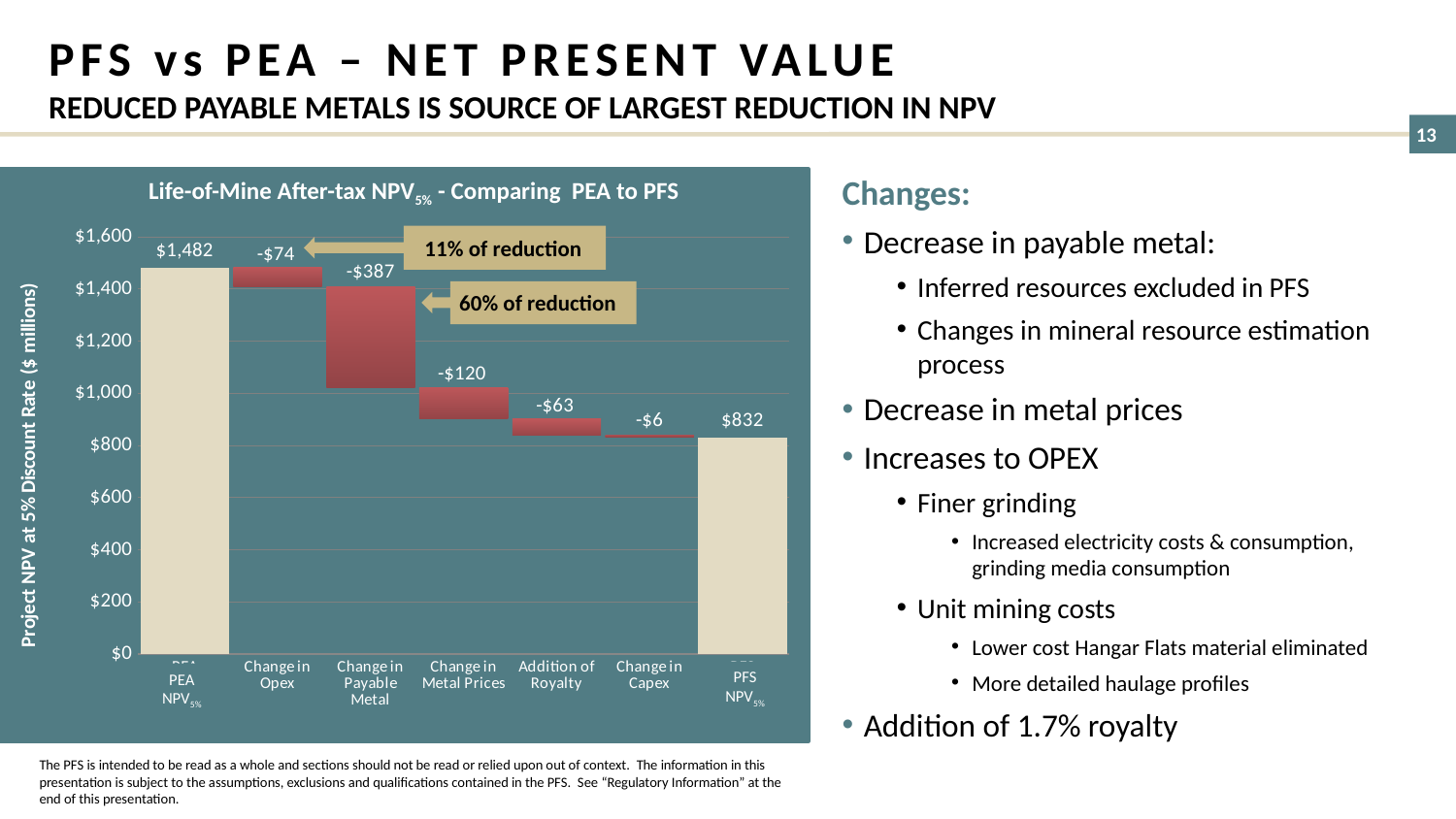
What kind of chart is shown on the slide? Waterfall bar chart What is the difference between the PEA NPV5% and the PFS NPV5%? $650 What is the value shown for Change in Metal Prices? -$120 Which reduction is larger: Change in Opex or Change in Metal Prices? Change in Metal Prices What is the value shown for PEA NPV5% in the chart? $1,482 What is the value shown for Change in Payable Metal? -$387 What is the title of the chart? Life-of-Mine After-tax NPV5% - Comparing PEA to PFS Which change category has the largest reduction in NPV? Change in Payable Metal How many categories are shown on the x axis of the chart? 7 Which change category has the smallest reduction in NPV? Change in Capex What is the value shown for Addition of Royalty? -$63 What is the value shown for PFS NPV5%? $832